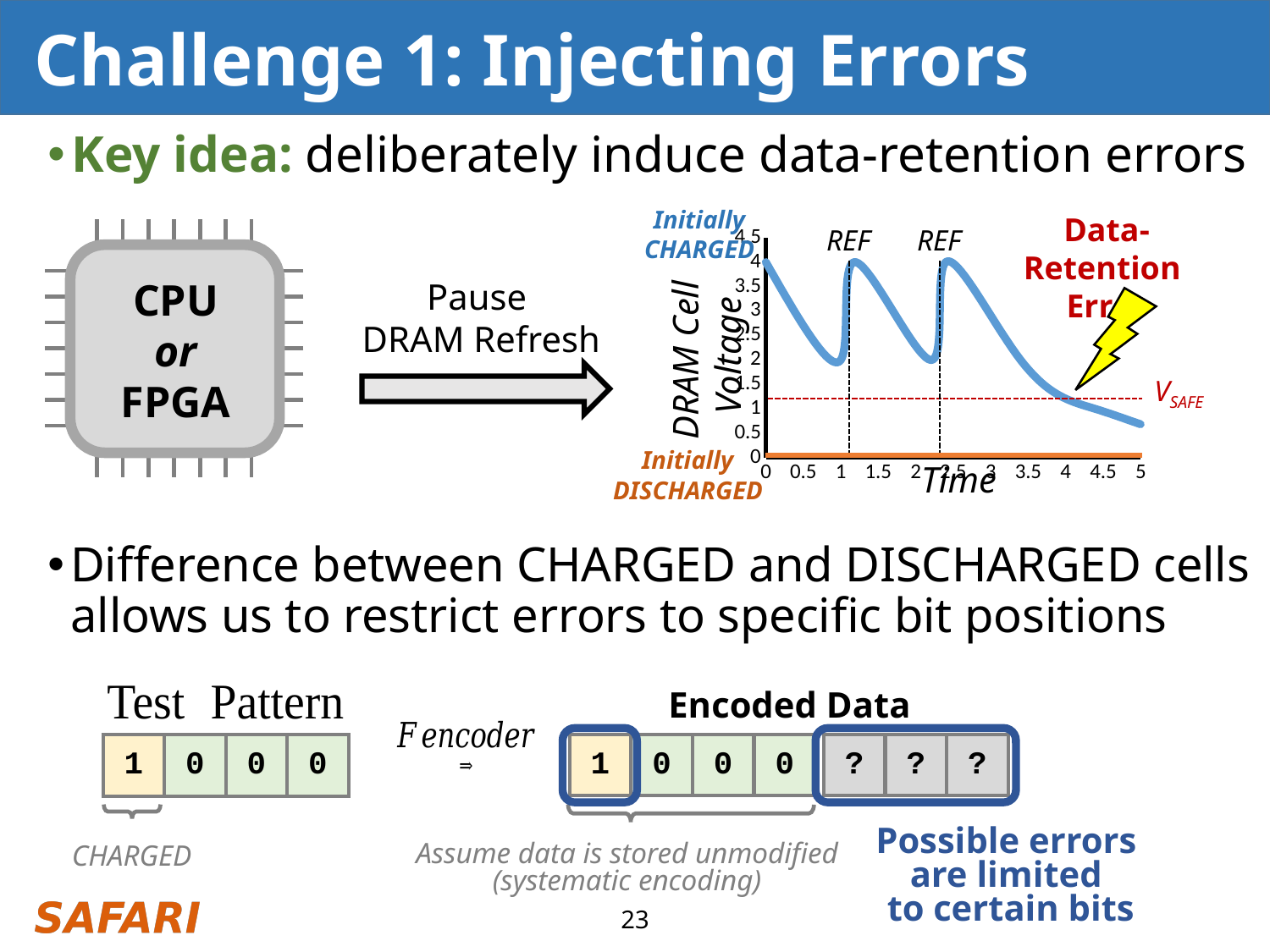
What is the label of the y axis of the chart? DRAM Cell Voltage Is the value of the Initially CHARGED line at time 4 greater or less than 2? less What is the label of the x axis of the chart? Time Is the value of the Initially DISCHARGED line at time 2 greater or less than 1? less Is the value of the Initially CHARGED line at time 0.5 greater or less than 2? greater Does the Initially CHARGED line rise or fall between time 0 and time 1? fall Does the Initially CHARGED line rise or fall between time 4 and time 5? fall At time 3, which line is higher, Initially CHARGED or Initially DISCHARGED? Initially CHARGED What kind of chart is shown on the slide? line chart